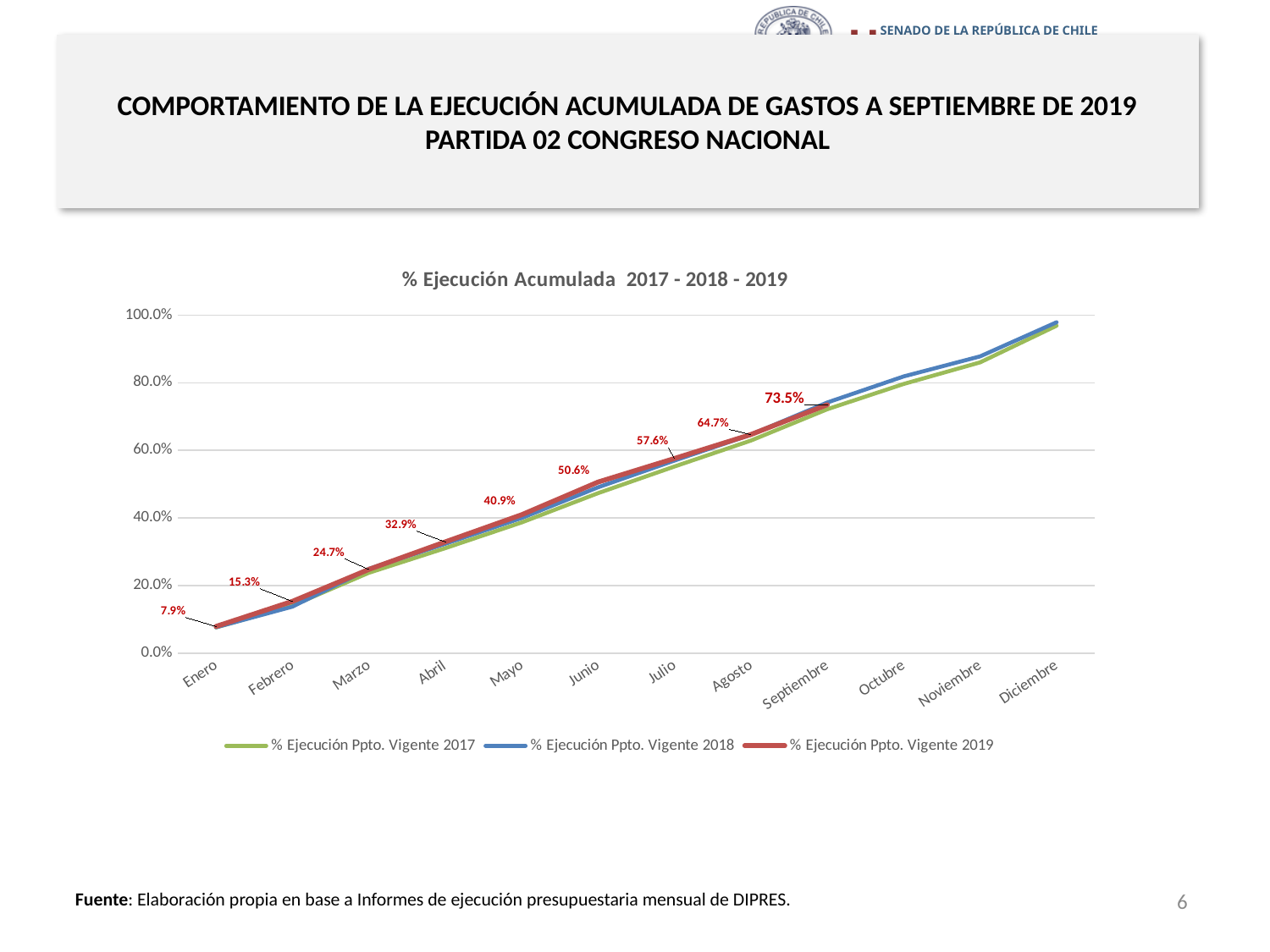
What is the difference between the 2019 values labelled for Mayo and Abril? 8.0% Is the value for the 2018 series in Diciembre greater or less than 80.0%? greater What kind of chart is shown on the slide? line chart What is the labelled value for the 2019 series in Marzo? 24.7% How many series does the legend list? 3 What is the labelled value for the 2019 series in Junio? 50.6% What is the labelled value for the 2019 series in Septiembre? 73.5% What is the title of the chart? % Ejecución Acumulada 2017 - 2018 - 2019 Do the values of the 2019 series rise or fall from Enero to Septiembre? rise What is the labelled value for the 2019 series in Enero? 7.9% What is the difference between the 2019 values labelled for Septiembre and Agosto? 8.8% How many months are shown along the x axis? 12